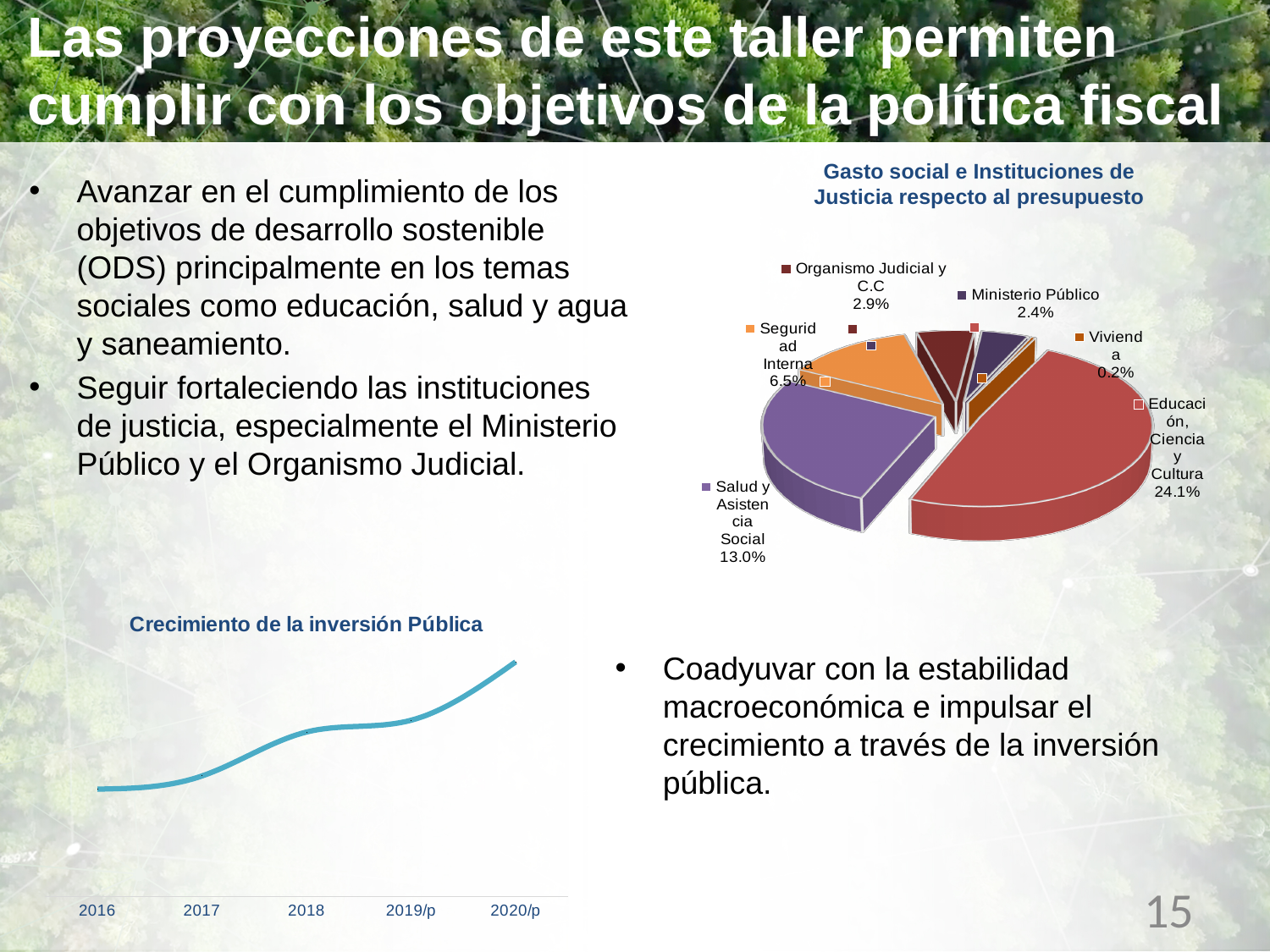
How many years are shown on the x axis of the chart 'Crecimiento de la inversión Pública'? 5 In the chart 'Crecimiento de la inversión Pública', do the values rise or fall from 2016 to 2020/p? Rise In the pie chart 'Gasto social e Instituciones de Justicia respecto al presupuesto', what is the value for Educación, Ciencia y Cultura? 24.1% In the pie chart 'Gasto social e Instituciones de Justicia respecto al presupuesto', which category has the smallest share? Vivienda In the pie chart 'Gasto social e Instituciones de Justicia respecto al presupuesto', what is the value for Salud y Asistencia Social? 13.0% In the pie chart 'Gasto social e Instituciones de Justicia respecto al presupuesto', what is the difference between Educación, Ciencia y Cultura and Salud y Asistencia Social? 11.1% What kind of chart is 'Crecimiento de la inversión Pública'? Line chart In the pie chart 'Gasto social e Instituciones de Justicia respecto al presupuesto', what is the value for Seguridad Interna? 6.5% How many categories are shown in the pie chart 'Gasto social e Instituciones de Justicia respecto al presupuesto'? 6 In the pie chart 'Gasto social e Instituciones de Justicia respecto al presupuesto', which category has the largest share? Educación, Ciencia y Cultura In the pie chart 'Gasto social e Instituciones de Justicia respecto al presupuesto', which is larger: Organismo Judicial y C.C or Ministerio Público? Organismo Judicial y C.C In the pie chart 'Gasto social e Instituciones de Justicia respecto al presupuesto', what is the value for Ministerio Público? 2.4%